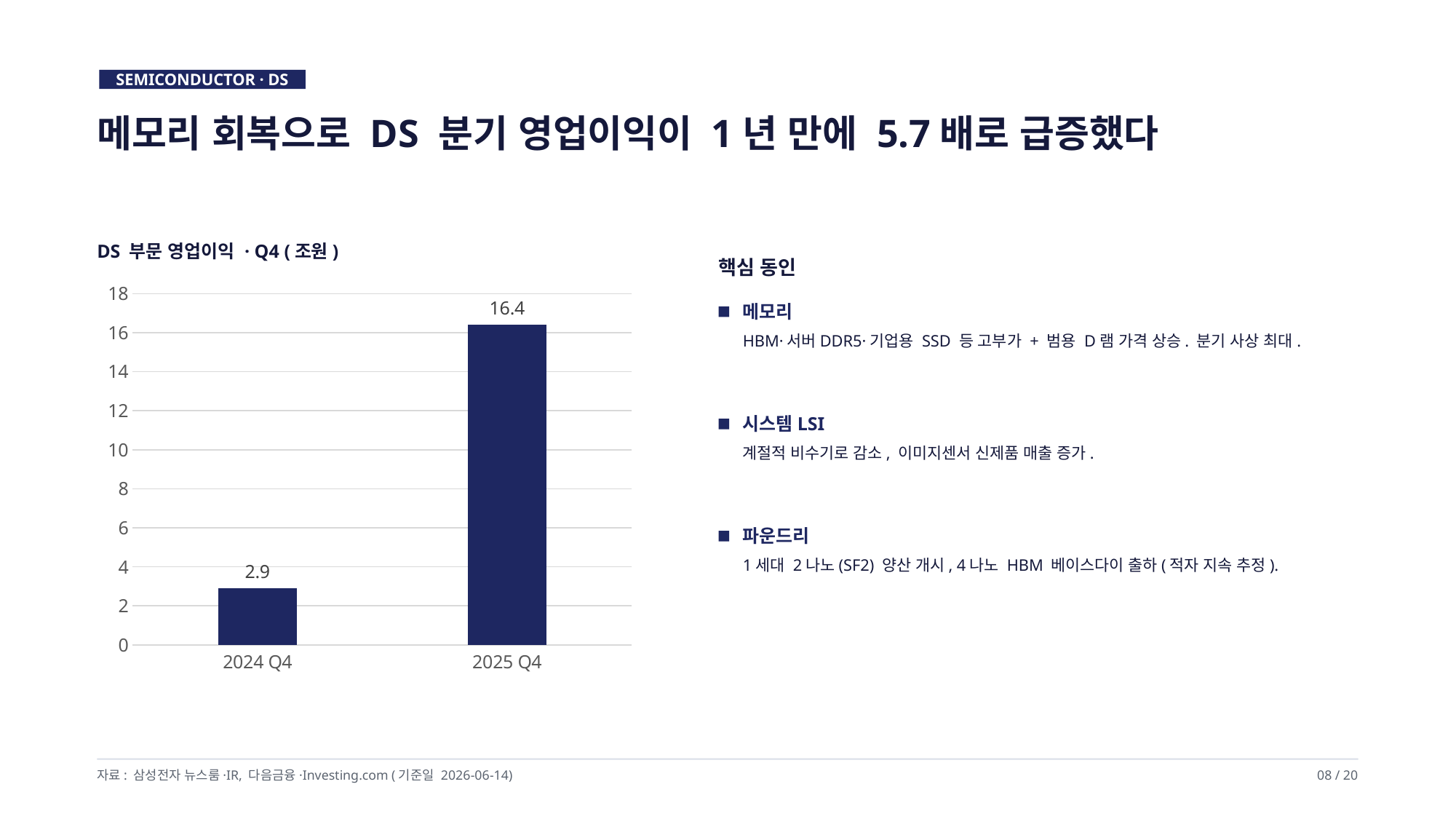
What is the DS operating profit value for 2024 Q4? 2.9 Which quarter has the higher DS operating profit? 2025 Q4 What is the title of the chart? DS 부문 영업이익 · Q4 (조원) What is the DS operating profit value for 2025 Q4? 16.4 Which quarter has the lower DS operating profit? 2024 Q4 Do the values rise or fall from 2024 Q4 to 2025 Q4? rise Is the value for 2024 Q4 greater or less than 4? less What is the difference between the 2025 Q4 and 2024 Q4 values? 13.5 Is the value for 2025 Q4 larger or smaller than the value for 2024 Q4? larger How many categories are shown on the x axis of the chart? 2 Is the value for 2025 Q4 greater or less than 14? greater What kind of chart is shown on the slide? bar chart